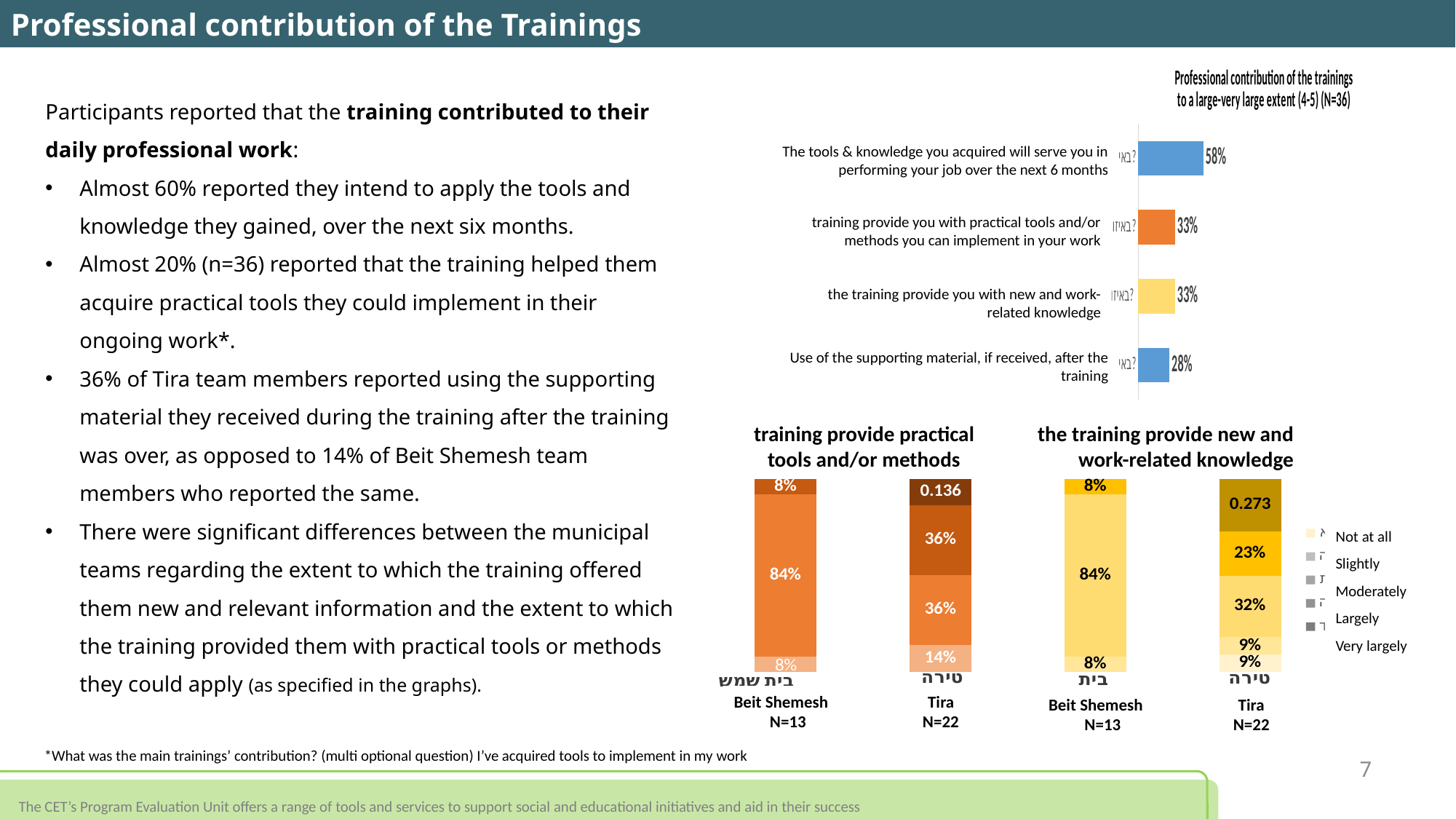
In the chart titled 'training provide practical tools and/or methods', what is the value of the bottom segment of the Tira bar? 14% What kind of chart is the one titled 'Professional contribution of the trainings to a large-very large extent'? Bar chart In the chart titled 'Professional contribution of the trainings to a large-very large extent', what is the value for 'The tools & knowledge you acquired will serve you in performing your job over the next 6 months'? 58% In the chart titled 'the training provide new and work-related knowledge', which bar has the larger largest segment, Beit Shemesh or Tira? Beit Shemesh In the chart titled 'training provide practical tools and/or methods', what is the largest segment value in the Beit Shemesh bar? 84% How many entries does the legend next to the stacked bar charts list? 5 In the chart titled 'Professional contribution of the trainings to a large-very large extent', which item has the lowest value? Use of the supporting material, if received, after the training In the chart titled 'Professional contribution of the trainings to a large-very large extent', what is the difference between the highest value and the lowest value? 30% In the chart titled 'Professional contribution of the trainings to a large-very large extent', what is the value for 'Use of the supporting material, if received, after the training'? 28% How many items are plotted in the chart titled 'Professional contribution of the trainings to a large-very large extent'? 4 In the chart titled 'Professional contribution of the trainings to a large-very large extent', which item has the highest value? The tools & knowledge you acquired will serve you in performing your job over the next 6 months In the chart titled 'the training provide new and work-related knowledge', what is the value of the top segment of the Tira bar? 0.273